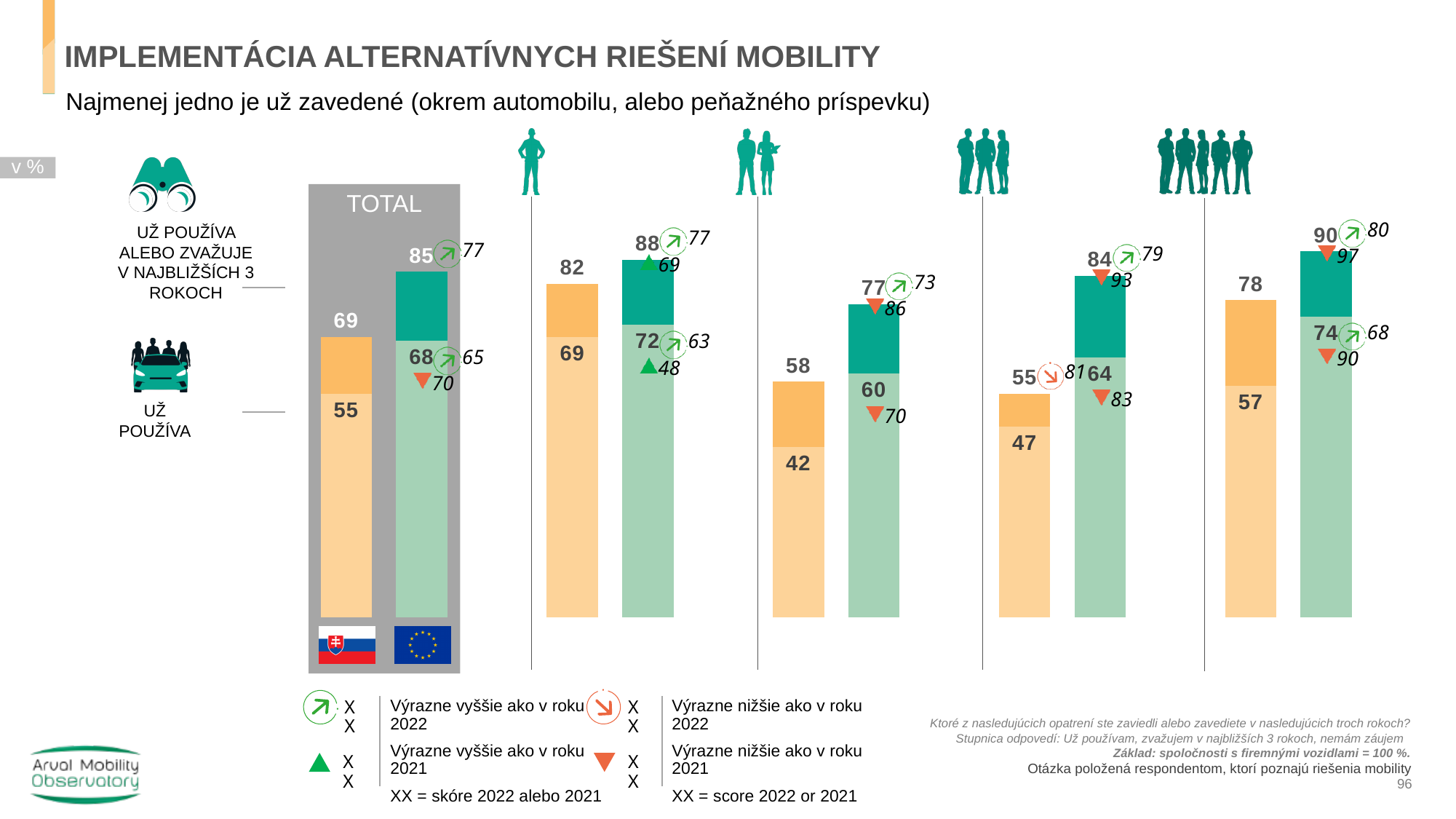
In the TOTAL group, what is the EU value for 'už používa'? 68 Across all groups, which Slovakia bar has the lowest 'už používa' value? 42 (second group right of TOTAL) In the TOTAL group, what is the Slovakia value for 'už používa'? 55 Across all groups, which EU bar has the highest 'už používa alebo zvažuje' value? 90 (rightmost group) In the third group to the right of TOTAL, what is the difference between the EU and Slovakia 'už používa' values? 17 In the TOTAL group, what is the difference between the EU and Slovakia values for 'už používa alebo zvažuje v najbližších 3 rokoch'? 16 Which flag is shown under the orange bars in the TOTAL group? Slovakia In the TOTAL group, what is the Slovakia value for 'už používa alebo zvažuje v najbližších 3 rokoch'? 69 In the first group to the right of TOTAL, which is larger: the Slovakia 'už používa' value or the EU 'už používa' value? EU (72) How many groups of bars are shown on the chart, including TOTAL? 5 What type of chart is shown on the slide? Bar chart In the rightmost group of bars (largest companies), what is the EU value for 'už používa alebo zvažuje v najbližších 3 rokoch'? 90